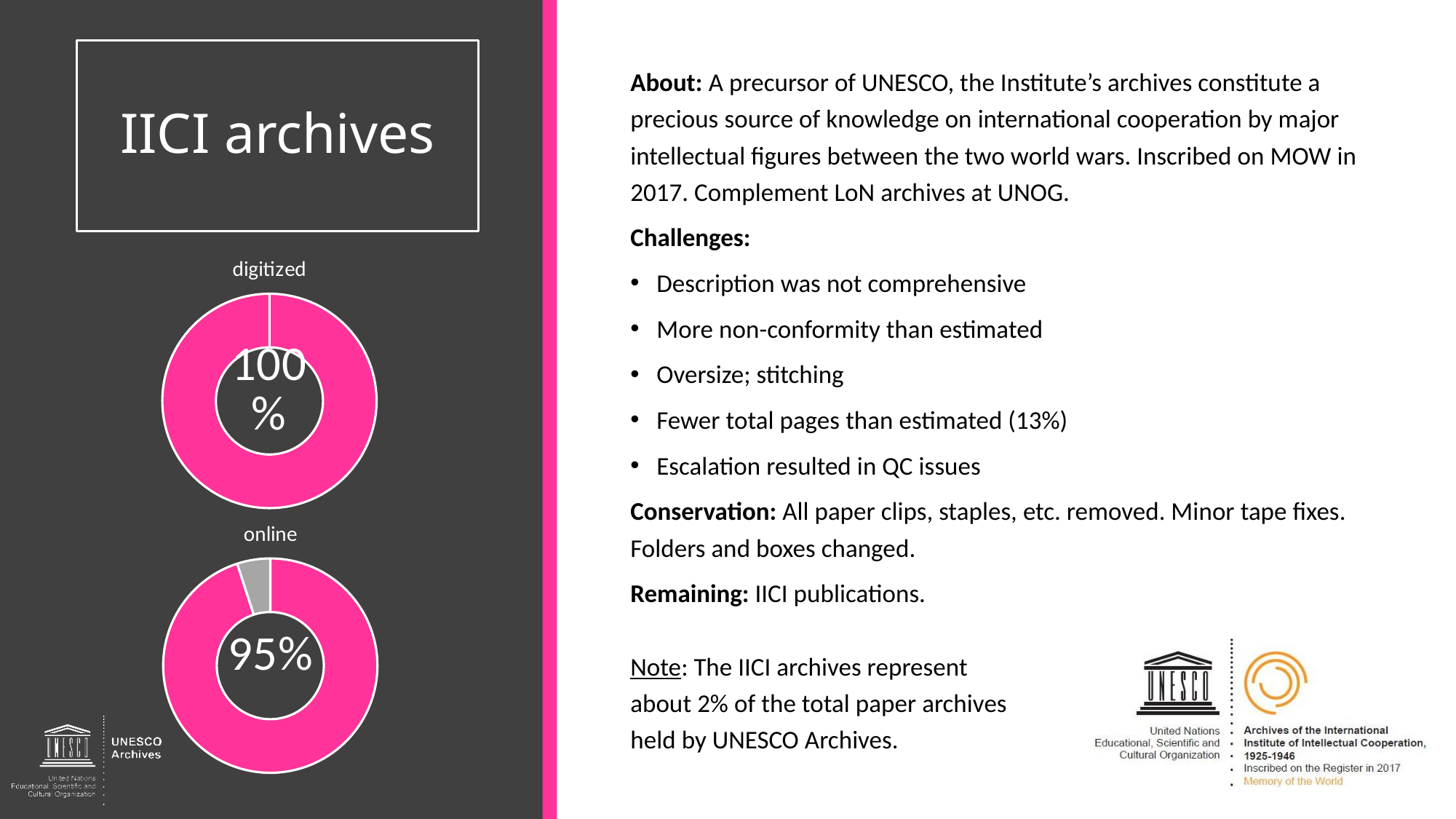
What kind of chart is used for the "digitized" and "online" figures? doughnut chart What is the difference between the percentage in the "digitized" chart and the percentage in the "online" chart? 5% Which of the two charts, "digitized" or "online", shows the higher percentage? digitized How many doughnut charts are shown on the slide? 2 What percentage is shown in the centre of the "online" chart? 95% Which of the two charts, "digitized" or "online", shows the lower percentage? online In the "online" chart, how many slices does the doughnut have? 2 What is the title of the bottom chart on the slide? online What is the title of the top chart on the slide? digitized What percentage is shown in the centre of the "digitized" chart? 100%